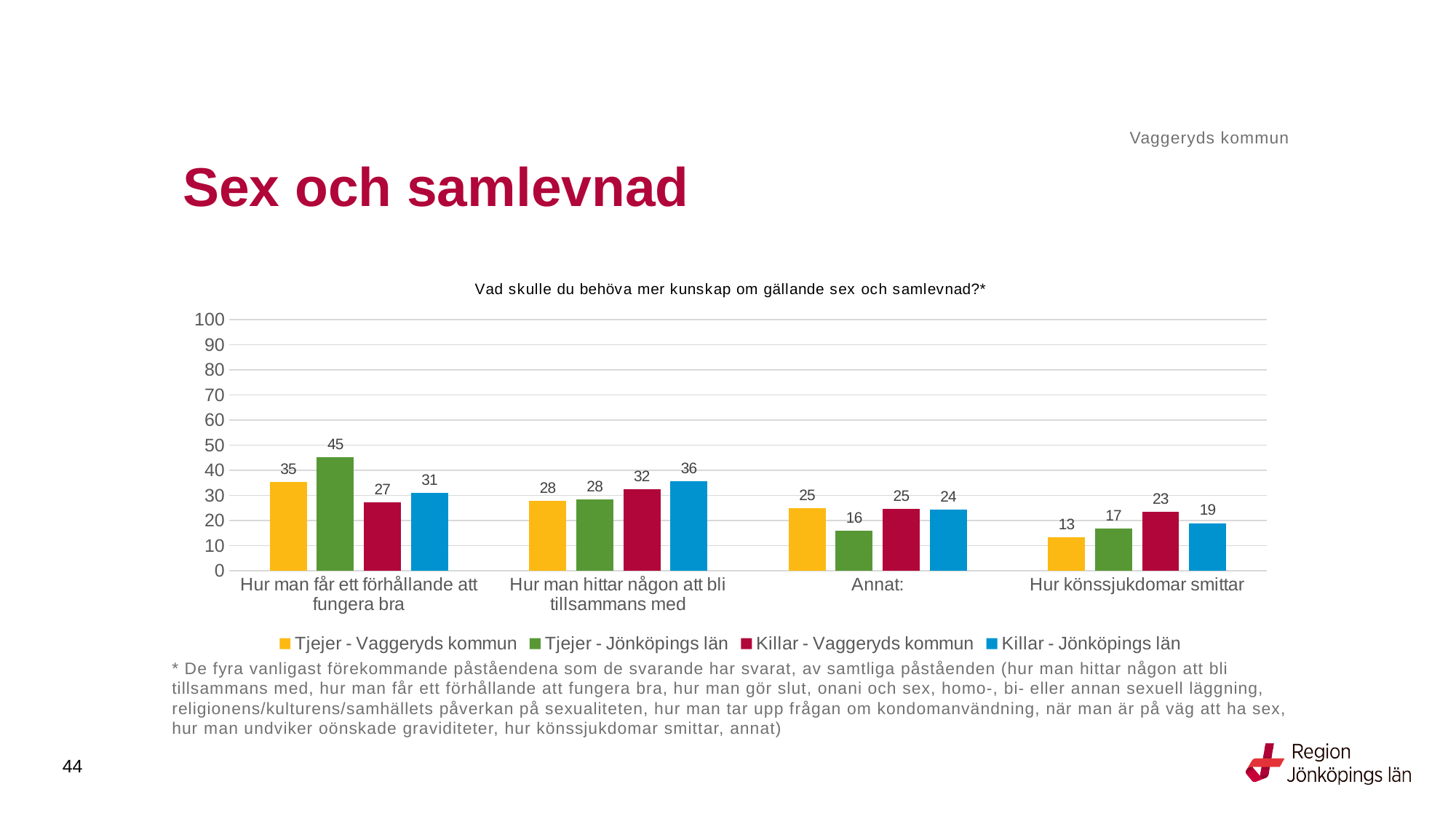
How many series does the legend list? 4 How many categories are shown on the x axis? 4 What is the title of the chart? Vad skulle du behöva mer kunskap om gällande sex och samlevnad?* Which category has the highest value for Killar - Vaggeryds kommun? Hur man hittar någon att bli tillsammans med What is the value for Killar - Jönköpings län in the category 'Hur man hittar någon att bli tillsammans med'? 36 What is the value for Tjejer - Jönköpings län in the category 'Hur man får ett förhållande att fungera bra'? 45 Do the values for Tjejer - Vaggeryds kommun rise or fall from left to right along the x axis? Fall In the category 'Annat:', which is larger: Tjejer - Vaggeryds kommun or Tjejer - Jönköpings län? Tjejer - Vaggeryds kommun What is the difference between Tjejer - Jönköpings län and Tjejer - Vaggeryds kommun in the category 'Hur man får ett förhållande att fungera bra'? 10 What kind of chart is shown on the slide? Bar chart Which category has the lowest value for Tjejer - Jönköpings län? Annat: What is the value for Tjejer - Vaggeryds kommun in the category 'Hur könssjukdomar smittar'? 13